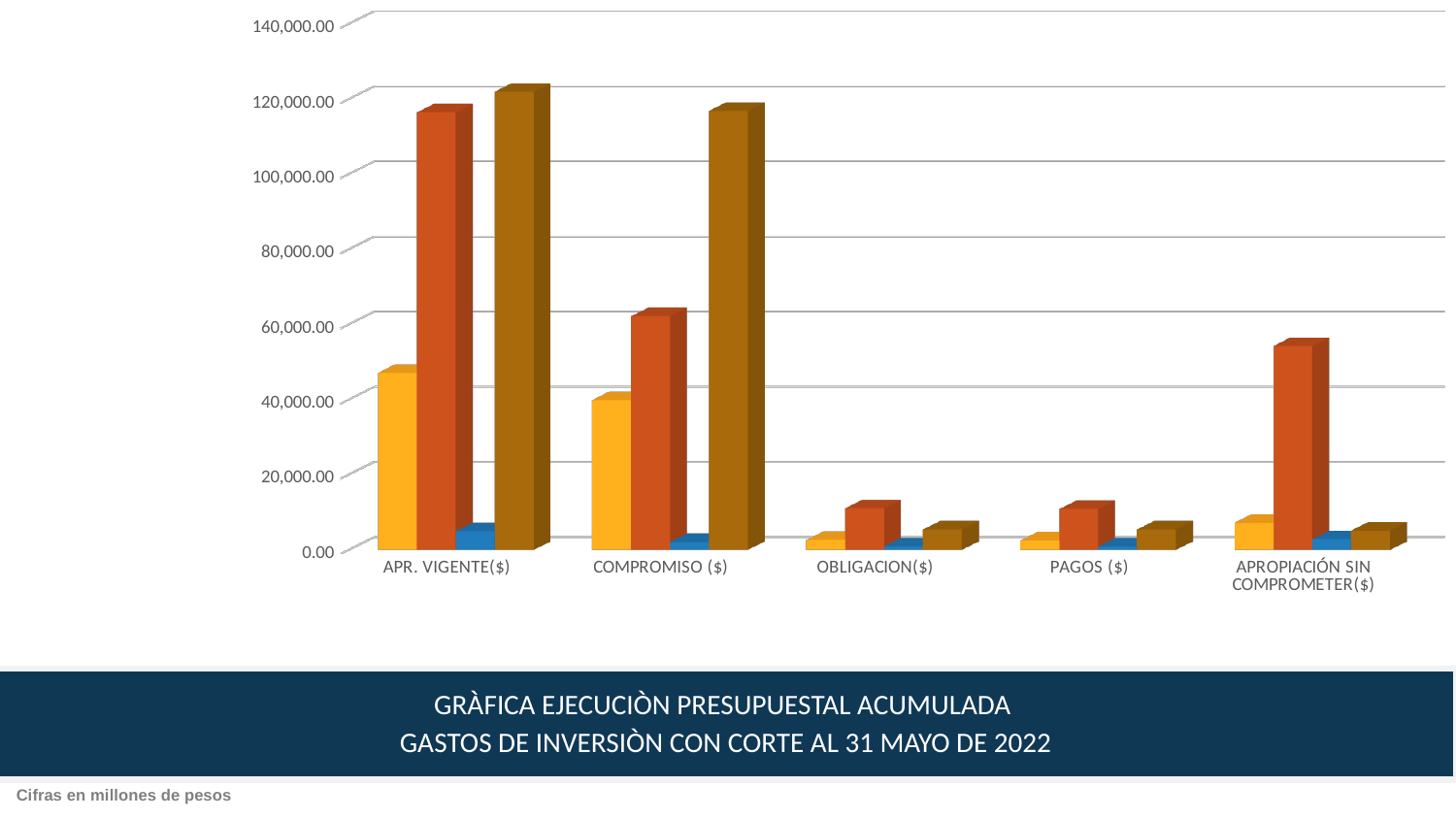
Is the value of the orange bar for APR. VIGENTE($) greater or less than 100,000.00? greater What kind of chart is shown on the slide? Bar chart Which category has the tallest orange bar? APR. VIGENTE($) Is the value of the orange bar for OBLIGACION($) greater or less than 20,000.00? less How many bars are plotted for each category in the chart? 4 Is the value of the yellow bar for APR. VIGENTE($) greater or less than 40,000.00? greater According to the note at the bottom of the slide, in what units are the figures expressed? Millones de pesos Which is larger: the yellow bar for COMPROMISO ($) or the yellow bar for PAGOS ($)? COMPROMISO ($) How many categories are shown on the x axis of the chart? 5 Which is larger: the orange bar for APR. VIGENTE($) or the orange bar for COMPROMISO ($)? APR. VIGENTE($)